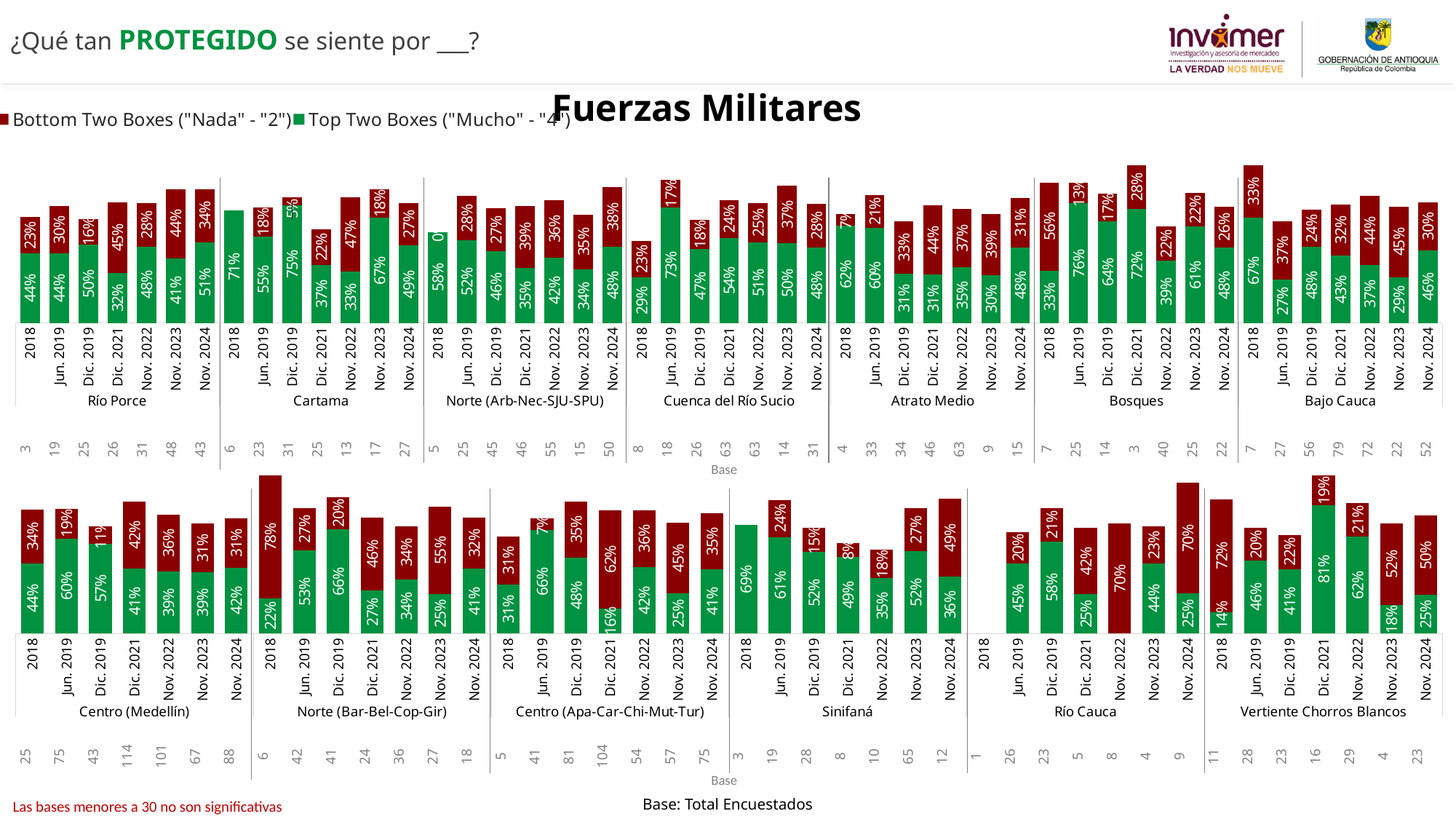
In the bottom chart, what is the Bottom Two Boxes value for Norte (Bar-Bel-Cop-Gir) in 2018? 78% In the top chart, what is the Bottom Two Boxes value for Bosques in 2018? 56% In the top chart, what is the total of the stacked bar for Bajo Cauca in 2018? 100% How many regions are shown in the top chart? 7 In the top chart, what is the Top Two Boxes value for Río Porce in Nov. 2024? 51% In the bottom chart, which year has the lowest Top Two Boxes value for Centro (Apa-Car-Chi-Mut-Tur)? Dic. 2021 In the top chart, what is the difference between the Top Two Boxes values for Cuenca del Río Sucio in Jun. 2019 and 2018? 44 percentage points What type of chart is shown on the slide? Stacked bar chart How many series does the legend list? 2 In the bottom chart, which is larger for Sinifaná in Nov. 2024: the Top Two Boxes value or the Bottom Two Boxes value? Bottom Two Boxes In the bottom chart, what is the Top Two Boxes value for Vertiente Chorros Blancos in Dic. 2021? 81% In the top chart, which year has the highest Top Two Boxes value for Cartama? Dic. 2019